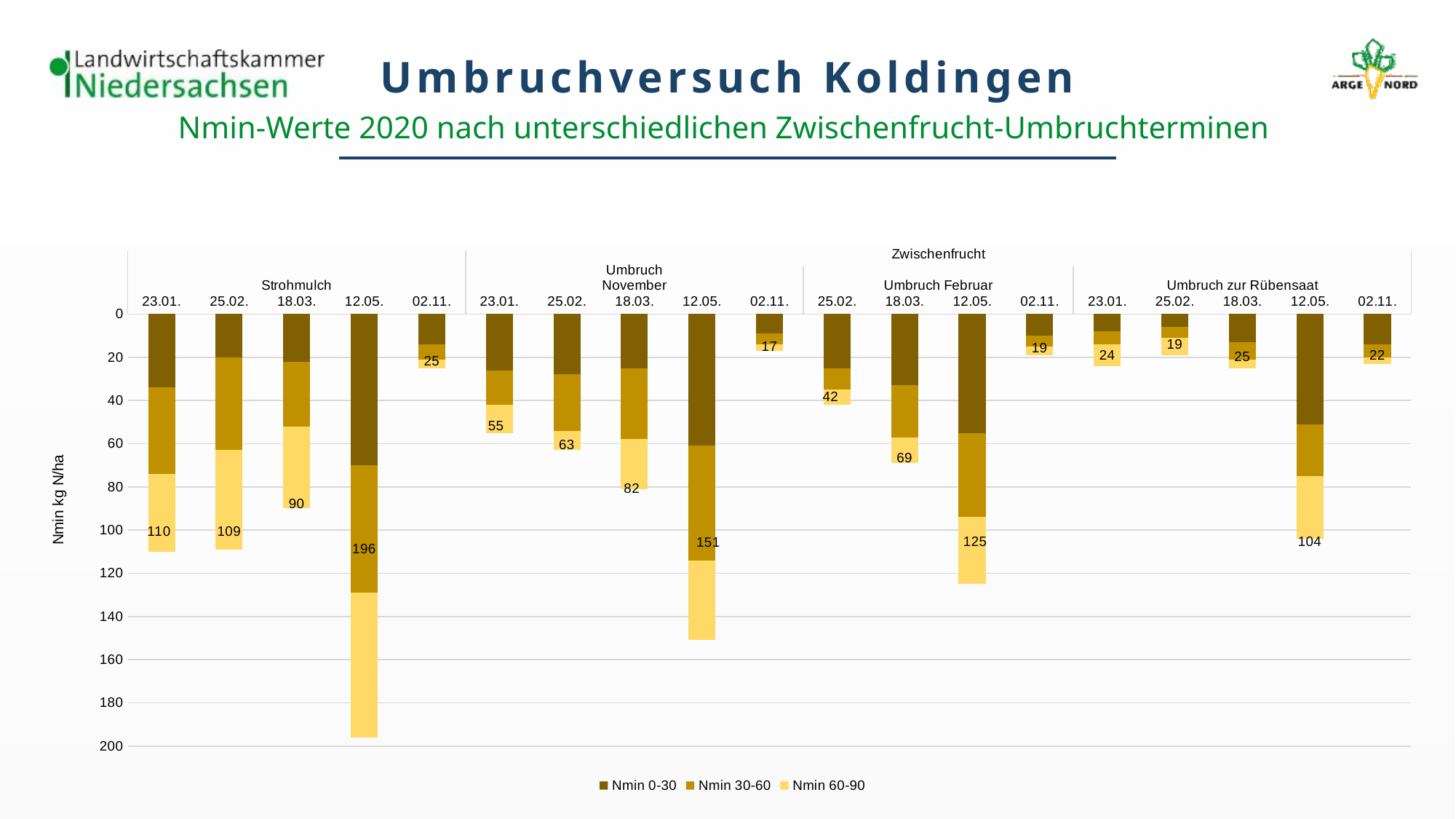
What is the total Nmin value labelled for the Strohmulch bar dated 12.05.? 196 What is the difference between the labelled totals for 12.05. under Strohmulch and 12.05. under Umbruch November? 45 What kind of chart is shown on the slide? Stacked bar chart Which bar has the highest labelled total Nmin value? Strohmulch 12.05. (196) What is the total Nmin value labelled for the Umbruch Februar bar dated 12.05.? 125 What is the total Nmin value labelled for the Umbruch November bar dated 18.03.? 82 Which is larger: the labelled total for 25.02. under Strohmulch or for 25.02. under Umbruch November? 25.02. under Strohmulch (109) How many bars are plotted in the chart? 19 What is the total Nmin value labelled for the Umbruch zur Rübensaat bar dated 02.11.? 22 Is the labelled total for 12.05. under Umbruch zur Rübensaat greater or less than 100? greater Which bar has the lowest labelled total Nmin value? Umbruch November 02.11. (17) How many series does the legend list? 3